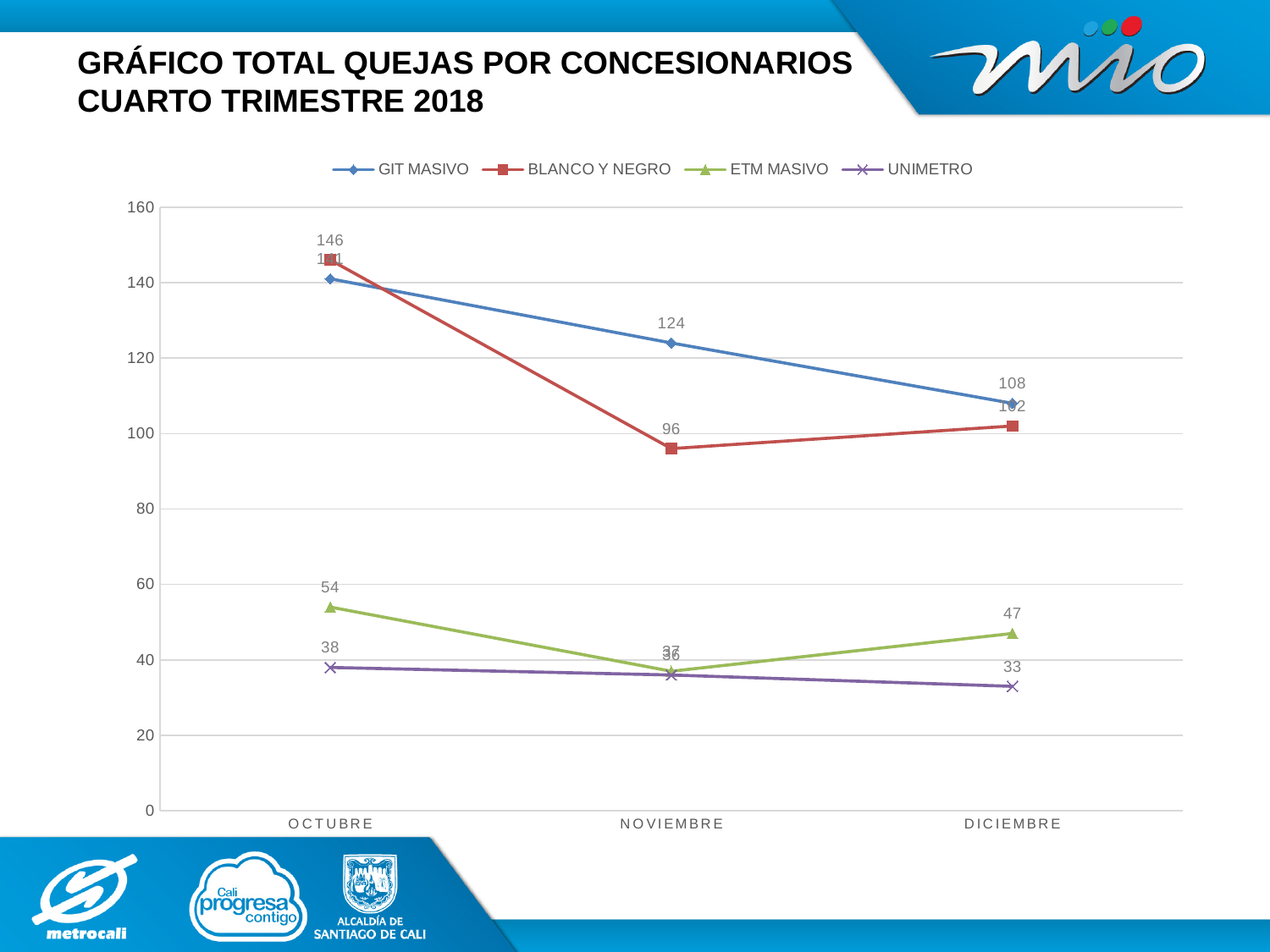
In NOVIEMBRE, which is larger: GIT MASIVO or BLANCO Y NEGRO? GIT MASIVO What is the value for BLANCO Y NEGRO in OCTUBRE? 146 What kind of chart is shown on the slide? line chart What is the value for GIT MASIVO in NOVIEMBRE? 124 In which month is ETM MASIVO highest? OCTUBRE Do the values for UNIMETRO rise or fall from OCTUBRE to DICIEMBRE? fall In which month is UNIMETRO lowest? DICIEMBRE How many series does the legend list? 4 What is the difference between the GIT MASIVO values for NOVIEMBRE and DICIEMBRE? 16 What is the value for ETM MASIVO in DICIEMBRE? 47 What is the value for UNIMETRO in DICIEMBRE? 33 How many months are shown on the x axis? 3